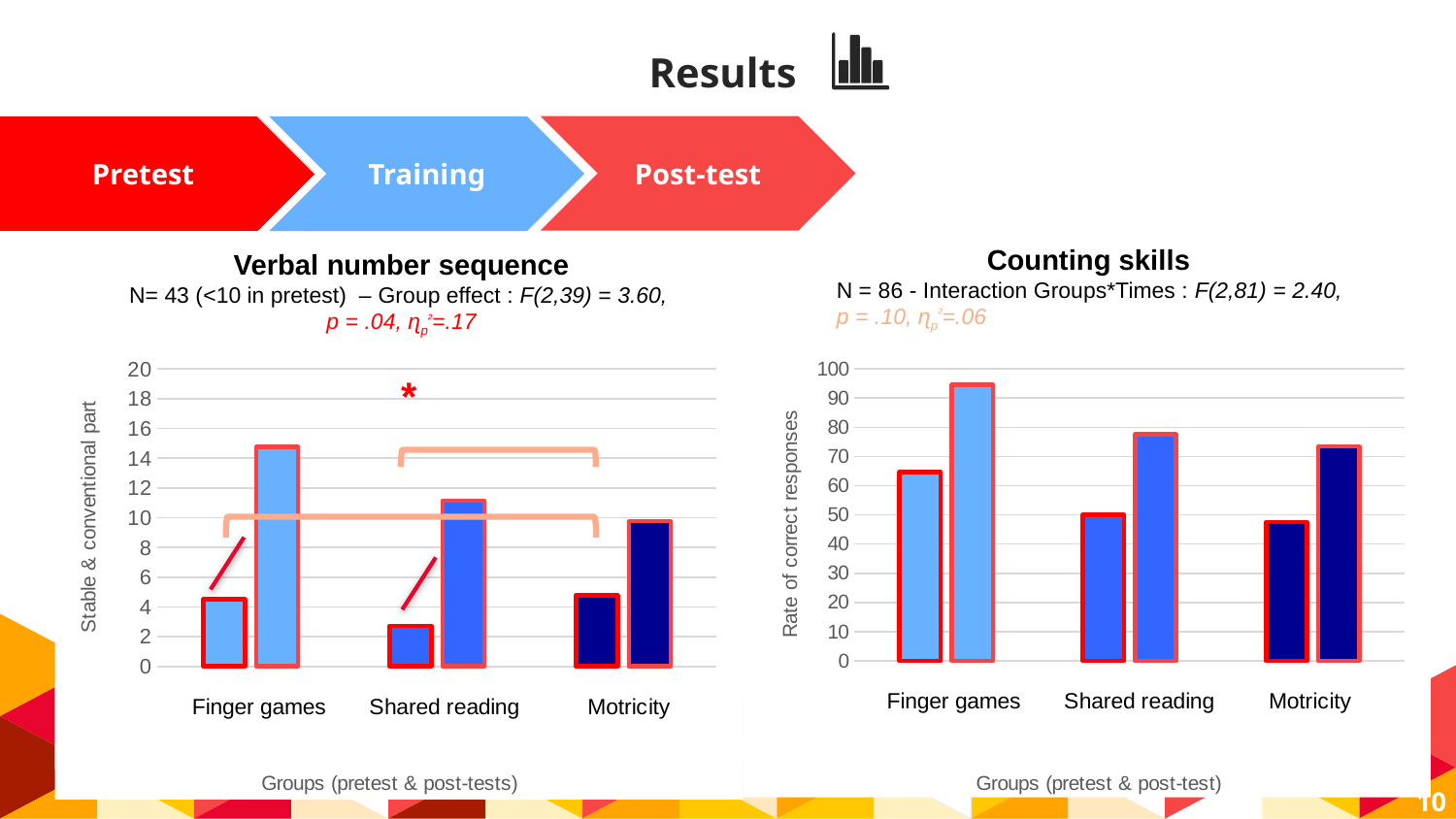
In the 'Verbal number sequence' chart, which group has the highest post-test bar? Finger games What is the y-axis label of the 'Verbal number sequence' chart? Stable & conventional part In the 'Counting skills' chart, which group has the highest post-test bar? Finger games In the 'Verbal number sequence' chart, is the post-test value for Finger games greater or less than 10? greater How many groups are shown on the x axis of the 'Counting skills' chart? 3 What kind of chart is the 'Verbal number sequence' chart? bar chart In the 'Verbal number sequence' chart, which is larger: the pretest value for Finger games or the pretest value for Shared reading? Finger games What kind of chart is the 'Counting skills' chart? bar chart In the 'Counting skills' chart, is the post-test value for Finger games greater or less than 90? greater In the 'Counting skills' chart, is the post-test value for Shared reading greater or less than 70? greater How many groups are shown on the x axis of the 'Verbal number sequence' chart? 3